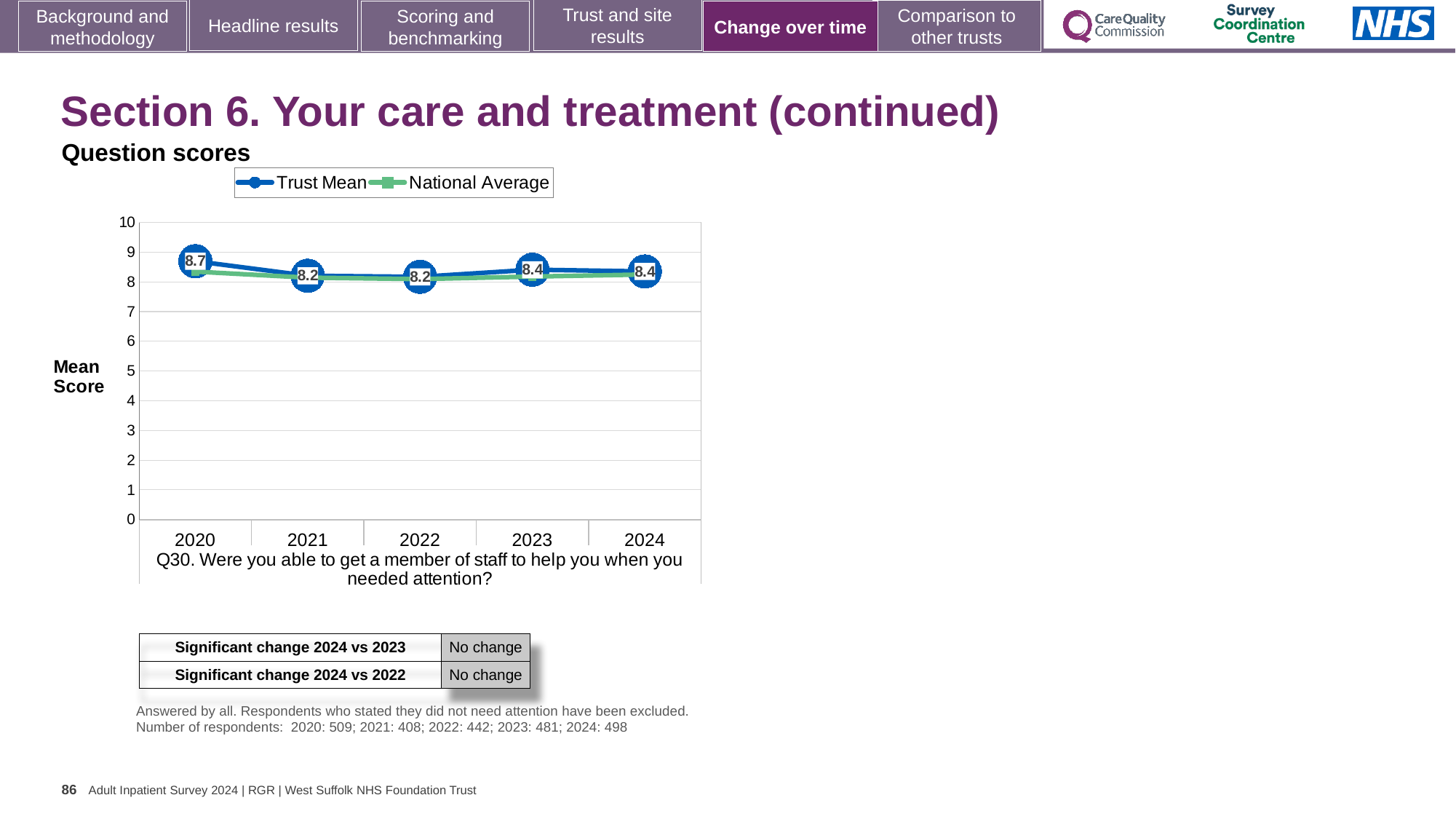
What is the Trust Mean score for 2020? 8.7 Which year has the larger Trust Mean, 2020 or 2023? 2020 In which year is the Trust Mean highest? 2020 Does the Trust Mean rise or fall from 2020 to 2021? fall What is the Trust Mean score for 2021? 8.2 What kind of chart is shown? line chart How many series does the legend list? 2 How many years are shown on the x axis? 5 What is the label on the y axis? Mean Score Is the National Average value for 2020 greater or less than 7? greater What is the Trust Mean score for 2024? 8.4 What is the difference between the Trust Mean in 2020 and in 2021? 0.5